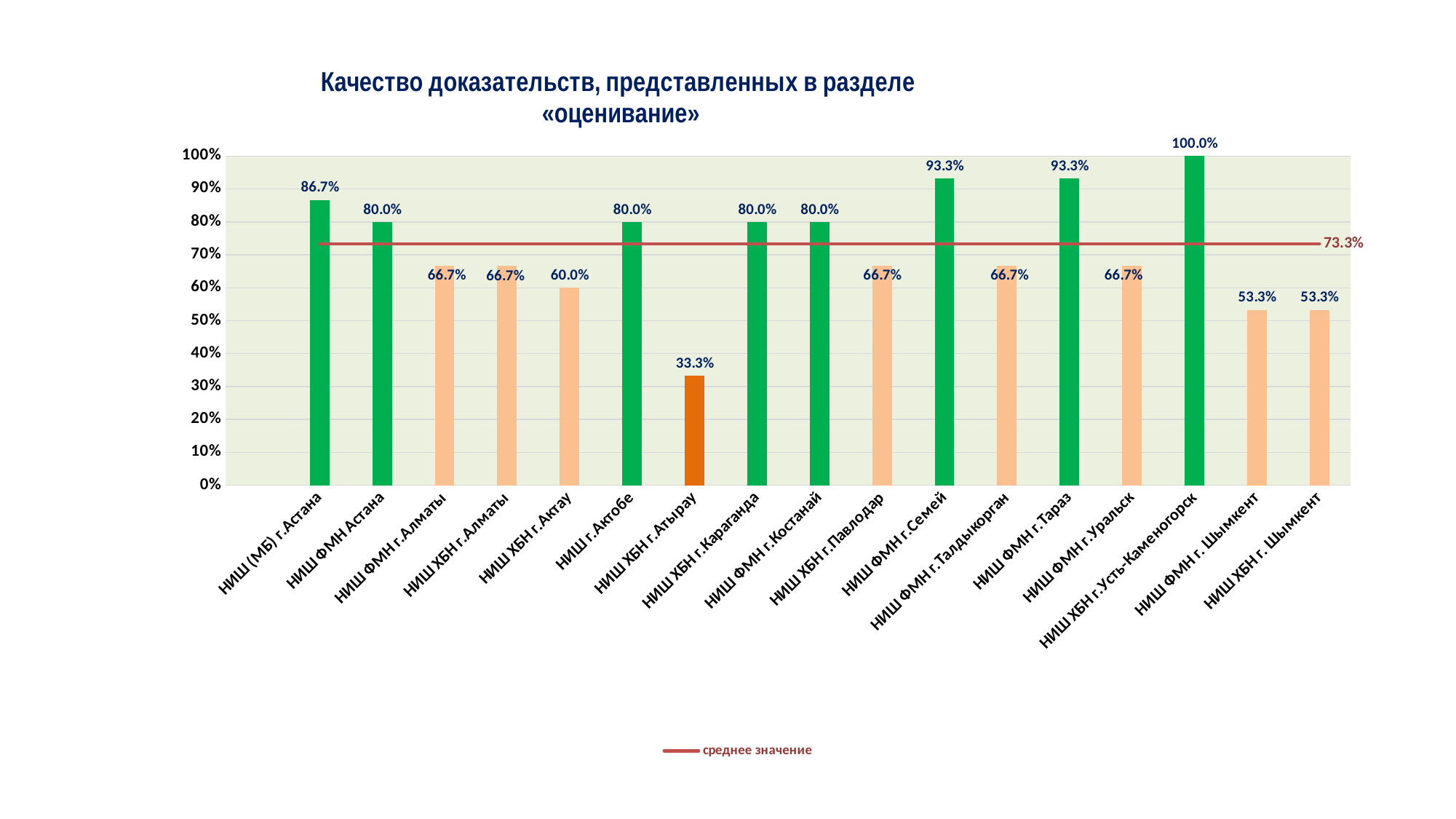
What kind of chart is this? Bar chart Which category has the lowest value? НИШ ХБН г.Атырау What value does the horizontal average line (среднее значение) mark? 73.3% What is the value for НИШ ФМН г.Семей? 93.3% Which is larger, the value for НИШ ХБН г.Актау or the value for НИШ г.Актобе? НИШ г.Актобе How many categories are shown on the x axis? 17 What is the value for НИШ ХБН г.Атырау? 33.3% Which category has the highest value? НИШ ХБН г.Усть-Каменогорск What is the title of the chart? Качество доказательств, представленных в разделе «оценивание» What is the value for НИШ (МБ) г.Астана? 86.7% What is the difference between the values for НИШ ХБН г.Усть-Каменогорск and НИШ ХБН г.Атырау? 66.7% What is the difference between the values for НИШ (МБ) г.Астана and НИШ ФМН Астана? 6.7%